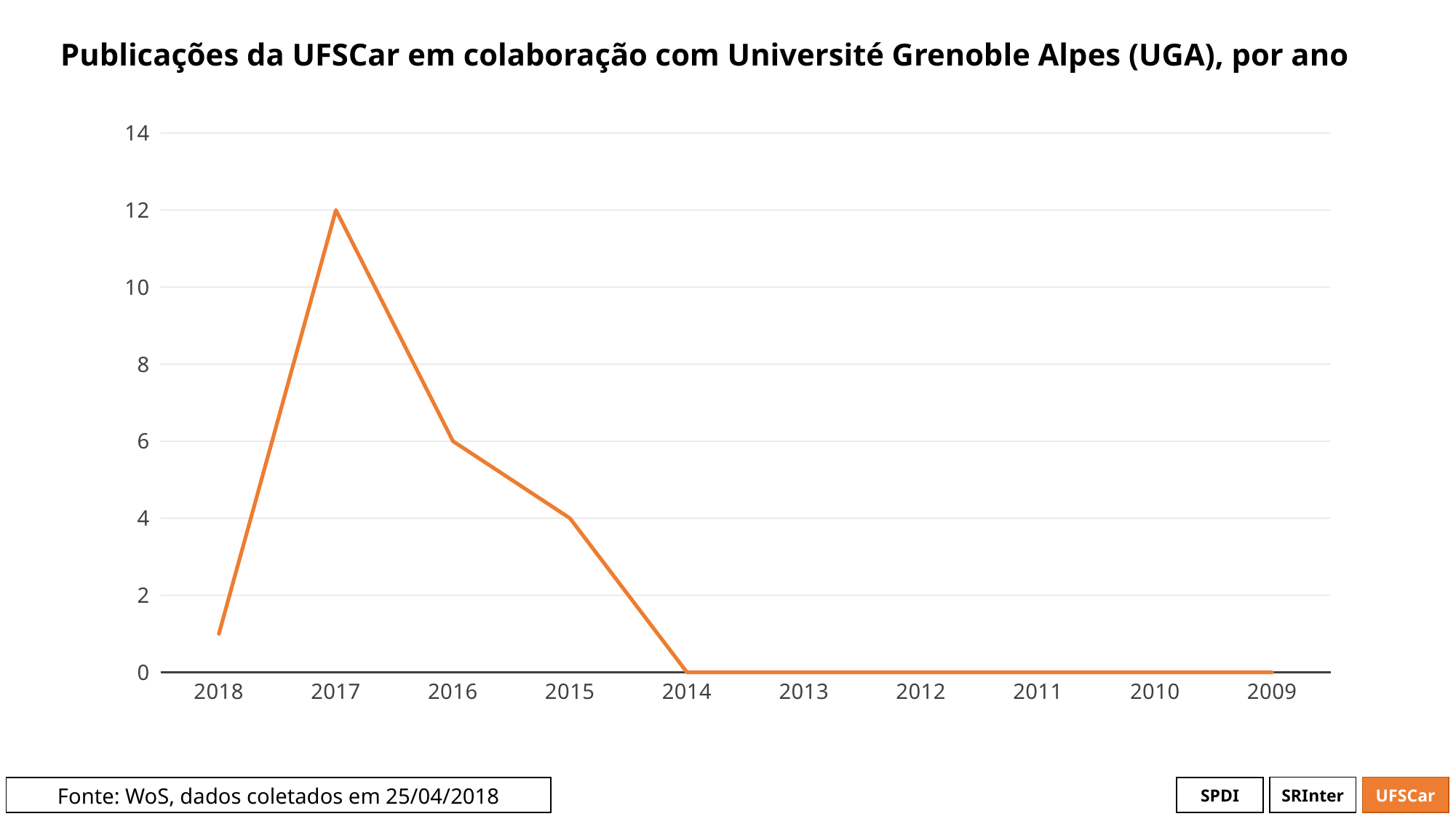
How many publications are shown for 2014? 0 How many publications are shown for 2017? 12 How many publications are shown for 2015? 4 What kind of chart is shown on the slide? line chart Is the value for 2018 greater or less than 2? less What is the title of the chart? Publicações da UFSCar em colaboração com Université Grenoble Alpes (UGA), por ano What is the difference between the values for 2017 and 2016? 6 Which year has the highest number of publications? 2017 How many years are shown on the x axis? 10 Which year has the larger value, 2016 or 2015? 2016 How many publications are shown for 2016? 6 Do the values rise or fall from 2017 to 2014 along the x axis? fall